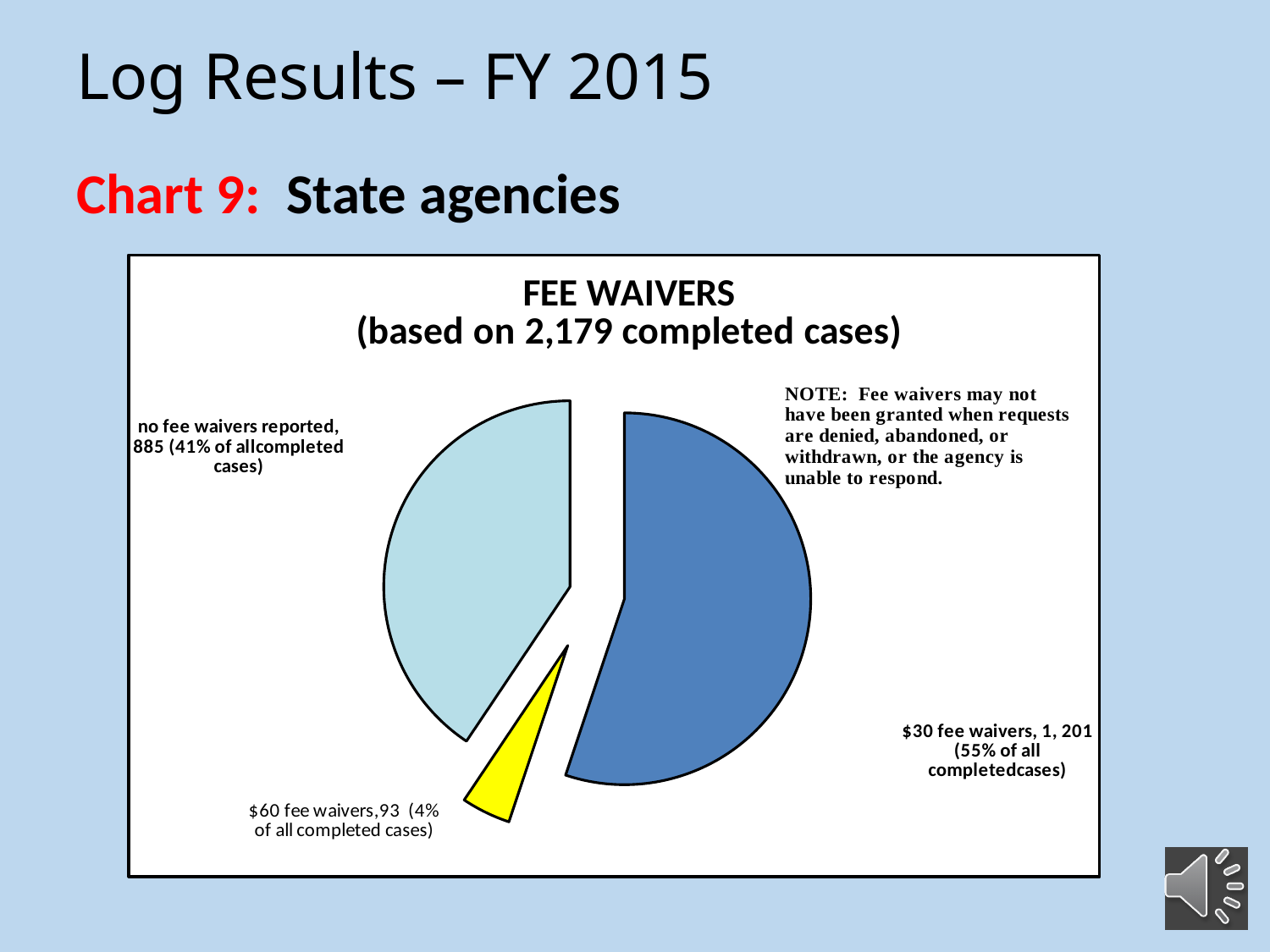
What share of all completed cases reported no fee waivers? 41% What share of all completed cases had $30 fee waivers? 55% How many more cases had $30 fee waivers than reported no fee waivers? 316 How many completed cases had $30 fee waivers? 1,201 How many slices does the pie chart have? 3 How many completed cases had $60 fee waivers? 93 Which category accounts for the smallest slice of the pie? $60 fee waivers What share of all completed cases had $60 fee waivers? 4% Which category accounts for the largest slice of the pie? $30 fee waivers What type of chart is shown on the slide? pie chart How many completed cases reported no fee waivers? 885 What is the title of the chart? FEE WAIVERS (based on 2,179 completed cases)